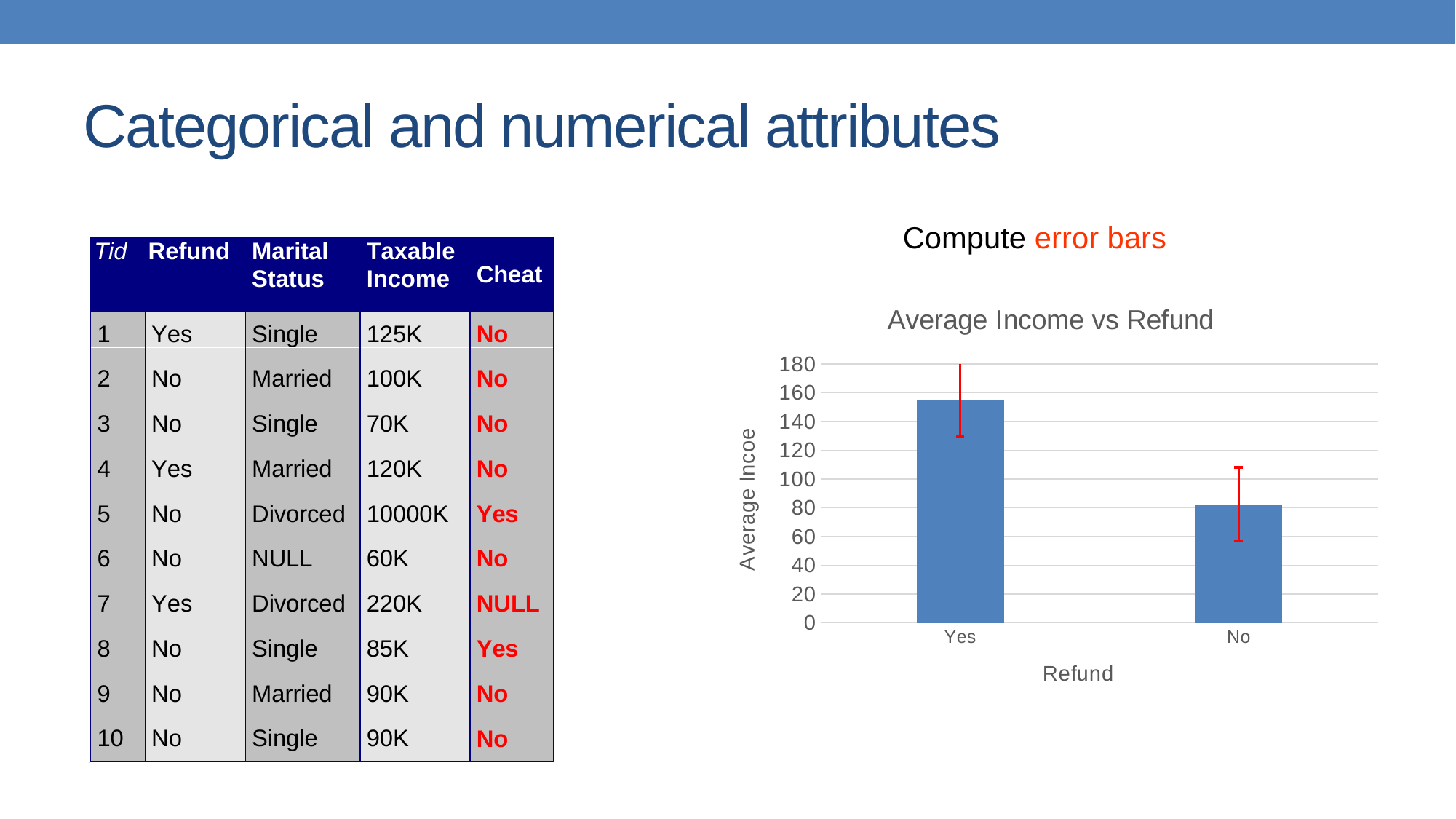
Which category has the lowest bar in the chart? No Is the value for Yes greater or less than 140? greater Is the value for No greater or less than 100? less Which category has the highest bar in the chart? Yes How many categories are plotted on the x axis of the chart? 2 Is the value for No greater or less than 60? greater What kind of chart is shown on the slide? bar chart What is the title of the chart? Average Income vs Refund Which bar is taller, Yes or No? Yes What is the label on the x axis of the chart? Refund